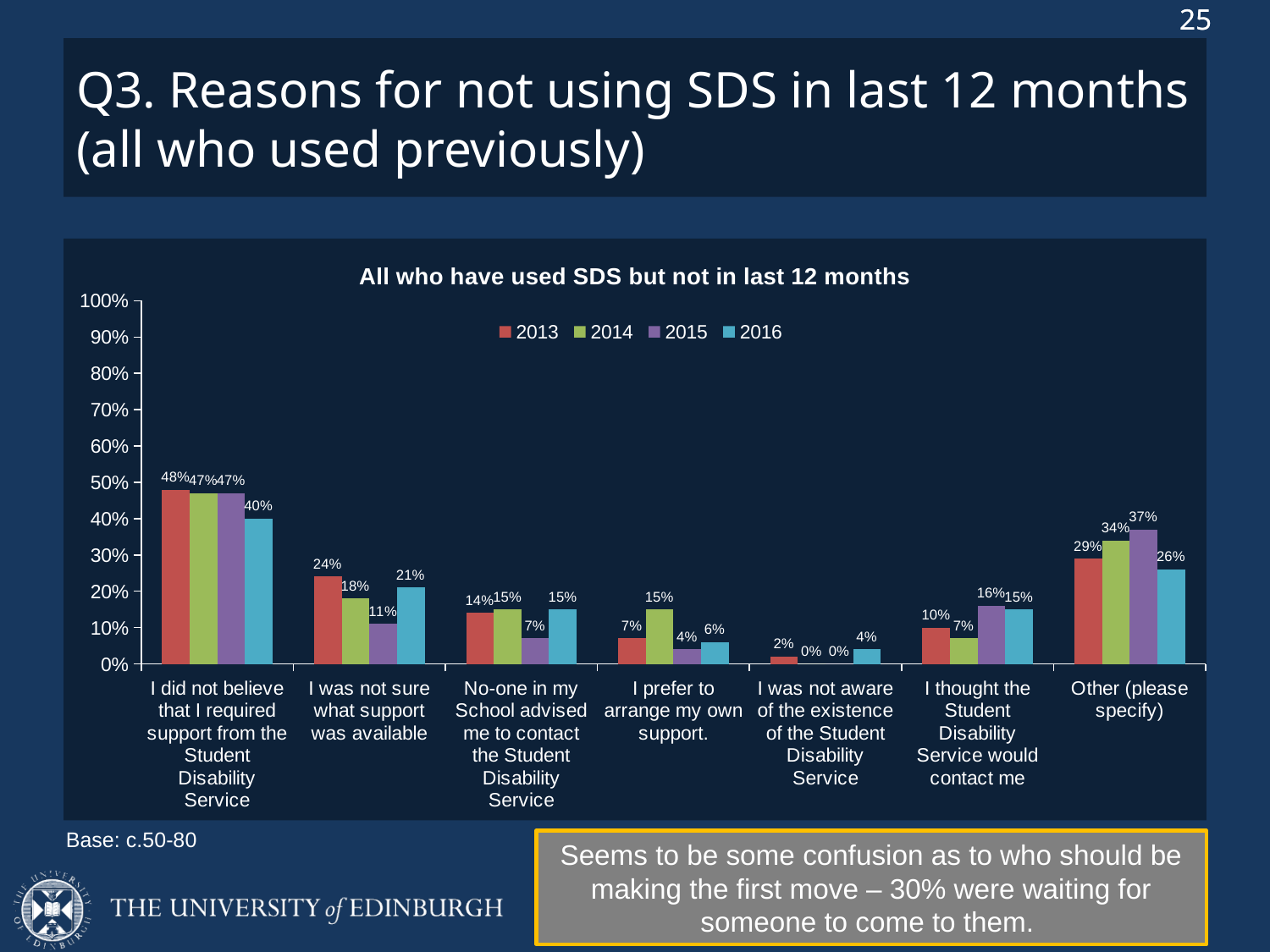
What kind of chart is shown on the slide? Bar chart Which is larger for "I was not sure what support was available": the 2014 value or the 2016 value? 2016 How many series does the legend list? 4 What is the 2014 value for "I prefer to arrange my own support"? 15% What is the 2013 value for "I was not sure what support was available"? 24% Which category has the highest 2013 value? I did not believe that I required support from the Student Disability Service What is the 2015 value for "I thought the Student Disability Service would contact me"? 16% Which category has the lowest 2016 value? I was not aware of the existence of the Student Disability Service How many categories are shown on the x axis? 7 What is the difference between the 2015 and 2016 values for "Other (please specify)"? 11% What is the title of the chart? All who have used SDS but not in last 12 months What is the 2016 value for "I did not believe that I required support from the Student Disability Service"? 40%